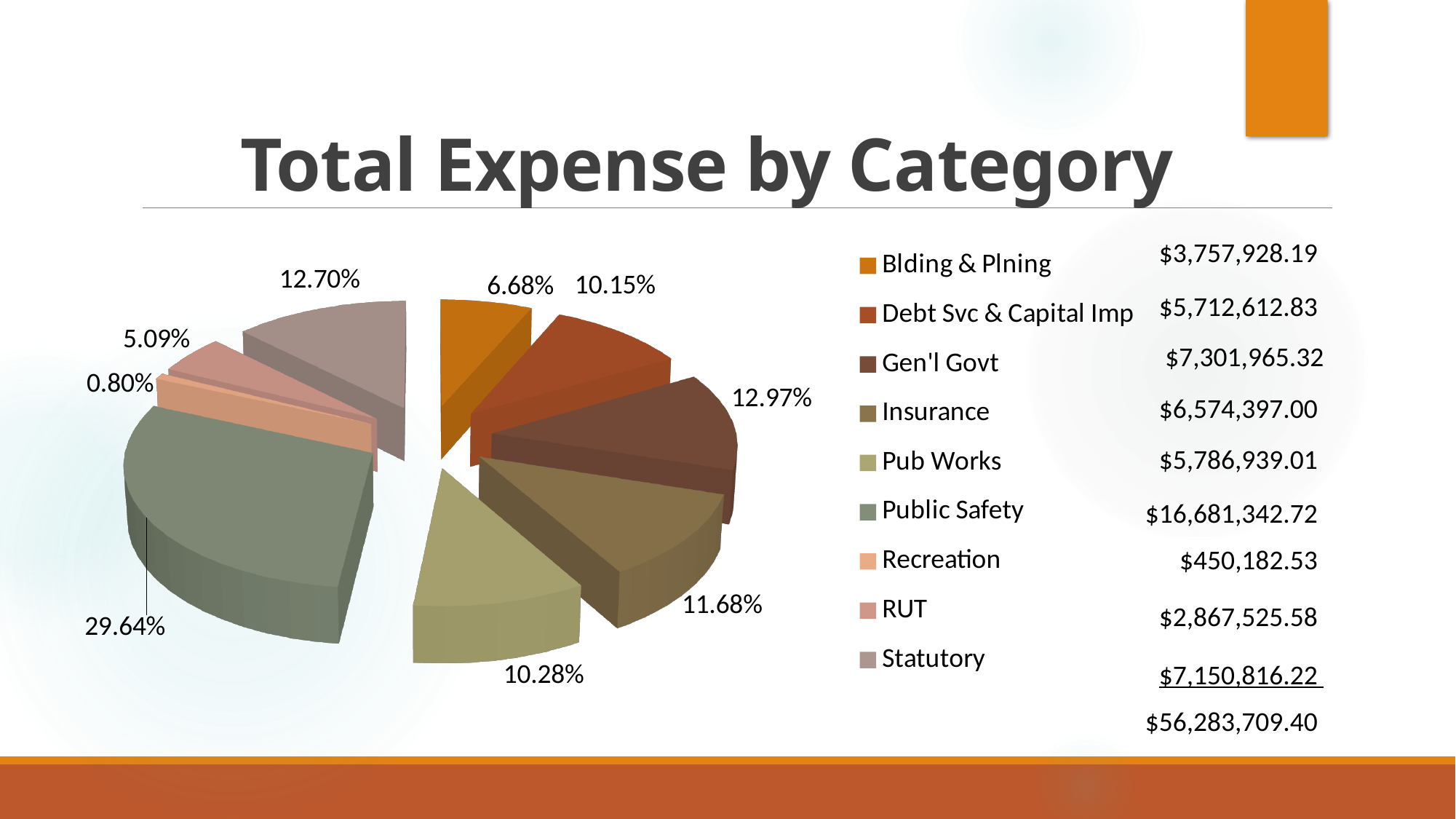
Which is larger, the share for Statutory or the share for Pub Works? Statutory What kind of chart is shown on the slide? pie chart What is the title of the chart? Total Expense by Category Which category has the largest slice of the pie? Public Safety What share of the pie does Recreation represent? 0.80% What share of the pie does Public Safety represent? 29.64% Which category has the smallest slice of the pie? Recreation What is the difference in percentage points between the Public Safety share and the Blding & Plning share? 22.96% What is the dollar amount shown for Insurance? $6,574,397.00 What is the dollar amount shown for RUT? $2,867,525.58 How many categories does the legend list? 9 What share of the pie does Gen'l Govt represent? 12.97%